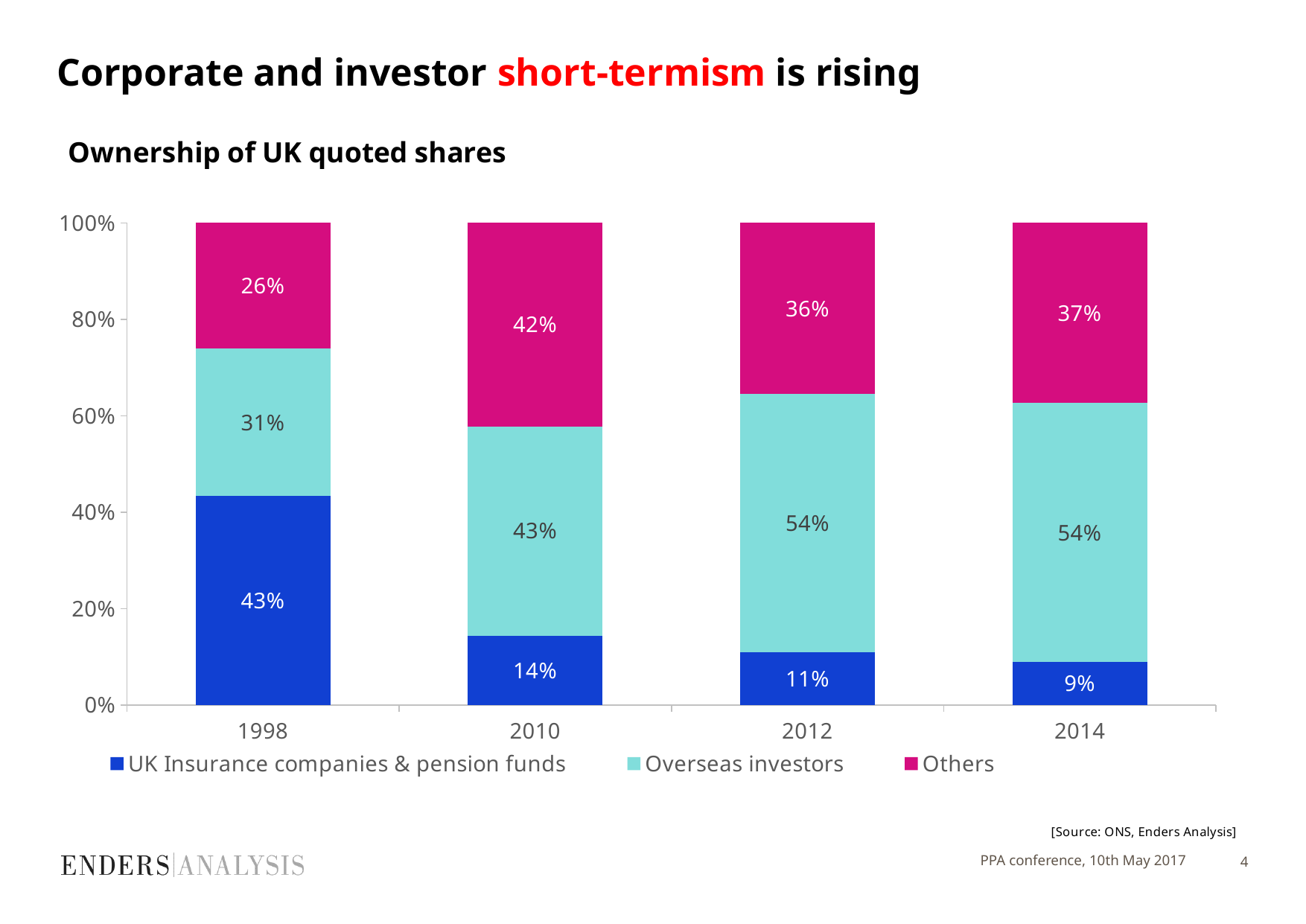
Does the share held by UK insurance companies & pension funds rise or fall from 1998 to 2014? Fall What share of UK quoted shares was held by UK insurance companies & pension funds in 1998? 43% What share of UK quoted shares was held by Others in 2010? 42% What is the title of the chart? Ownership of UK quoted shares What share of UK quoted shares was held by overseas investors in 2012? 54% By how many percentage points did the share held by UK insurance companies & pension funds fall between 1998 and 2014? 34 percentage points What kind of chart is shown on the slide? Stacked bar chart Which was larger in 2010: the share held by overseas investors or the share held by Others? Overseas investors How many series does the legend list? 3 In which year was the share held by UK insurance companies & pension funds lowest? 2014 In which year was the share held by Others highest? 2010 How many years are shown on the x axis? 4